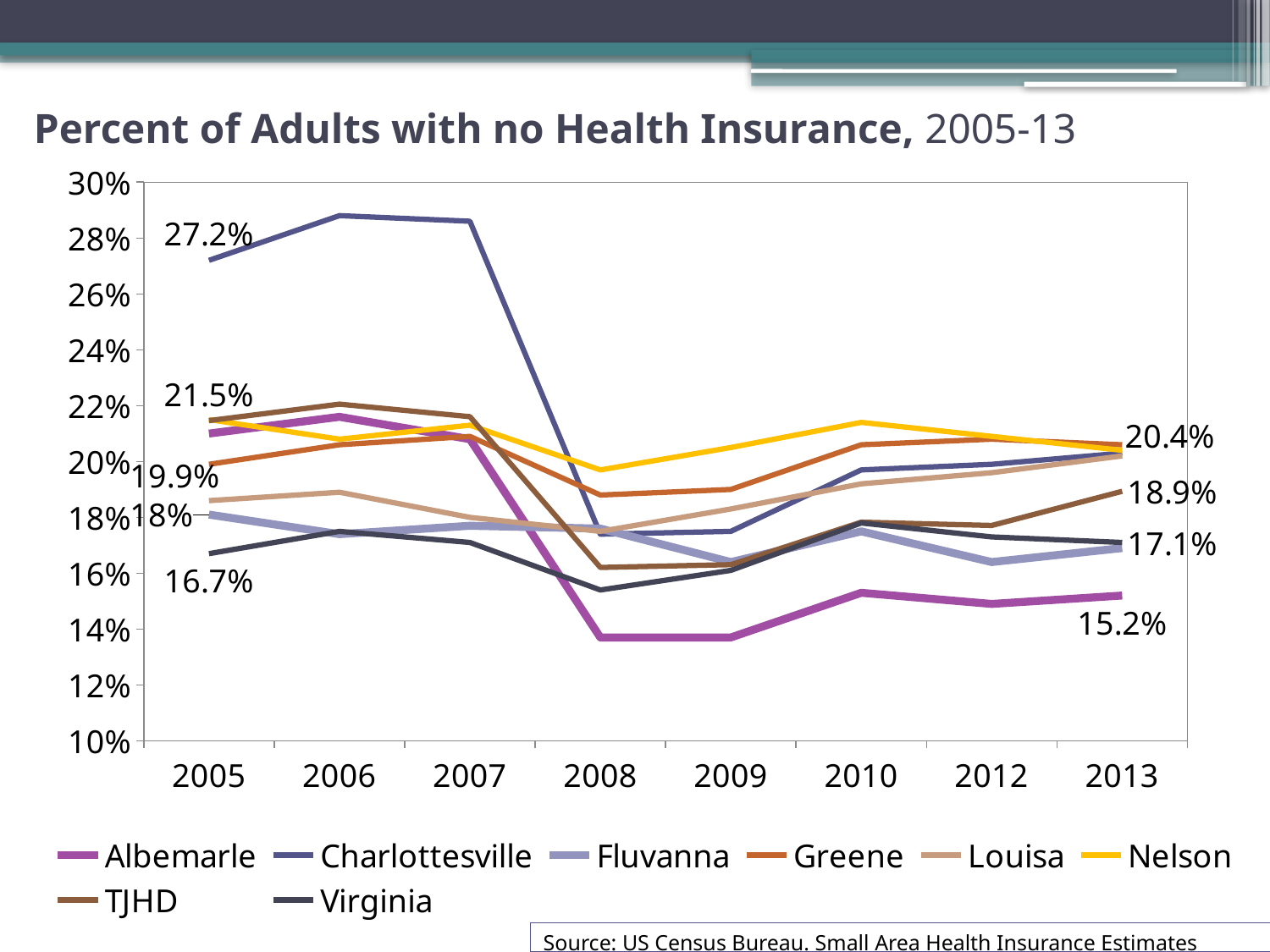
Which series had the highest percent of adults with no health insurance in 2005? Charlottesville What type of chart is shown on the slide? line chart What was the percent of adults with no health insurance in Albemarle in 2013? 15.2% What was the percent of adults with no health insurance in TJHD in 2013? 18.9% What was the percent of adults with no health insurance in Virginia in 2005? 16.7% Does the Albemarle line rise or fall overall from 2005 to 2013? fall How many series does the legend list? 8 Which series had the lowest percent of adults with no health insurance in 2008? Albemarle How many years are shown on the x axis? 8 What is the difference between Charlottesville's and Virginia's values in 2005? 10.5 percentage points Is the value for Charlottesville in 2006 greater or less than 28%? greater What was the percent of adults with no health insurance in Charlottesville in 2005? 27.2%